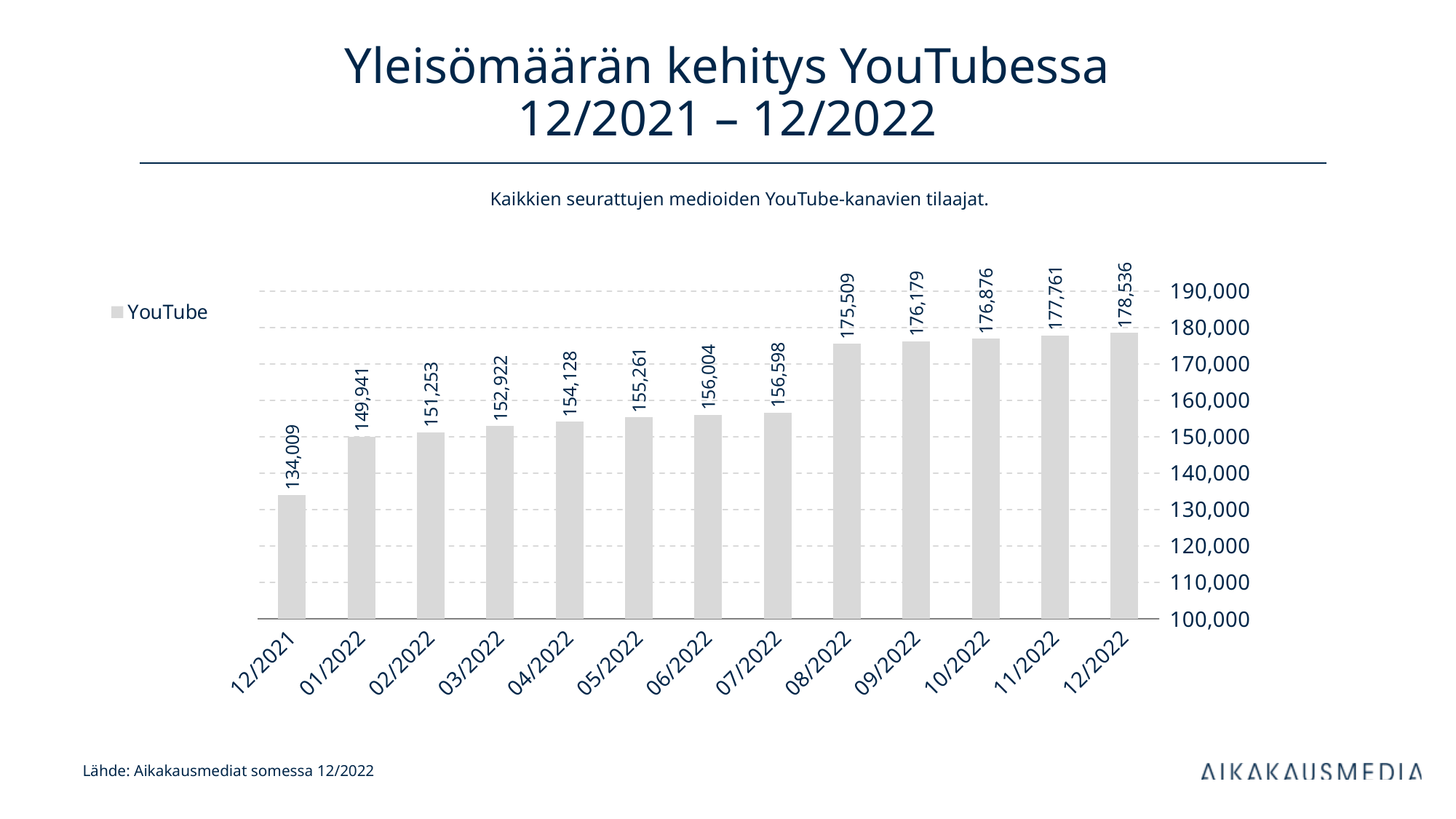
What is the difference between the values for 12/2022 and 12/2021? 44,527 What is the difference between the values for 08/2022 and 07/2022? 18,911 Which month has the lowest value? 12/2021 What kind of chart is shown on the slide? bar chart What is the value for 12/2021? 134,009 What is the value for 08/2022? 175,509 What is the value for 05/2022? 155,261 Do the values rise or fall from 12/2021 to 12/2022? rise How many months are shown on the x axis? 13 Which month has the highest value? 12/2022 Is the value for 06/2022 greater or less than 160,000? less Which is larger, the value for 03/2022 or the value for 09/2022? 09/2022